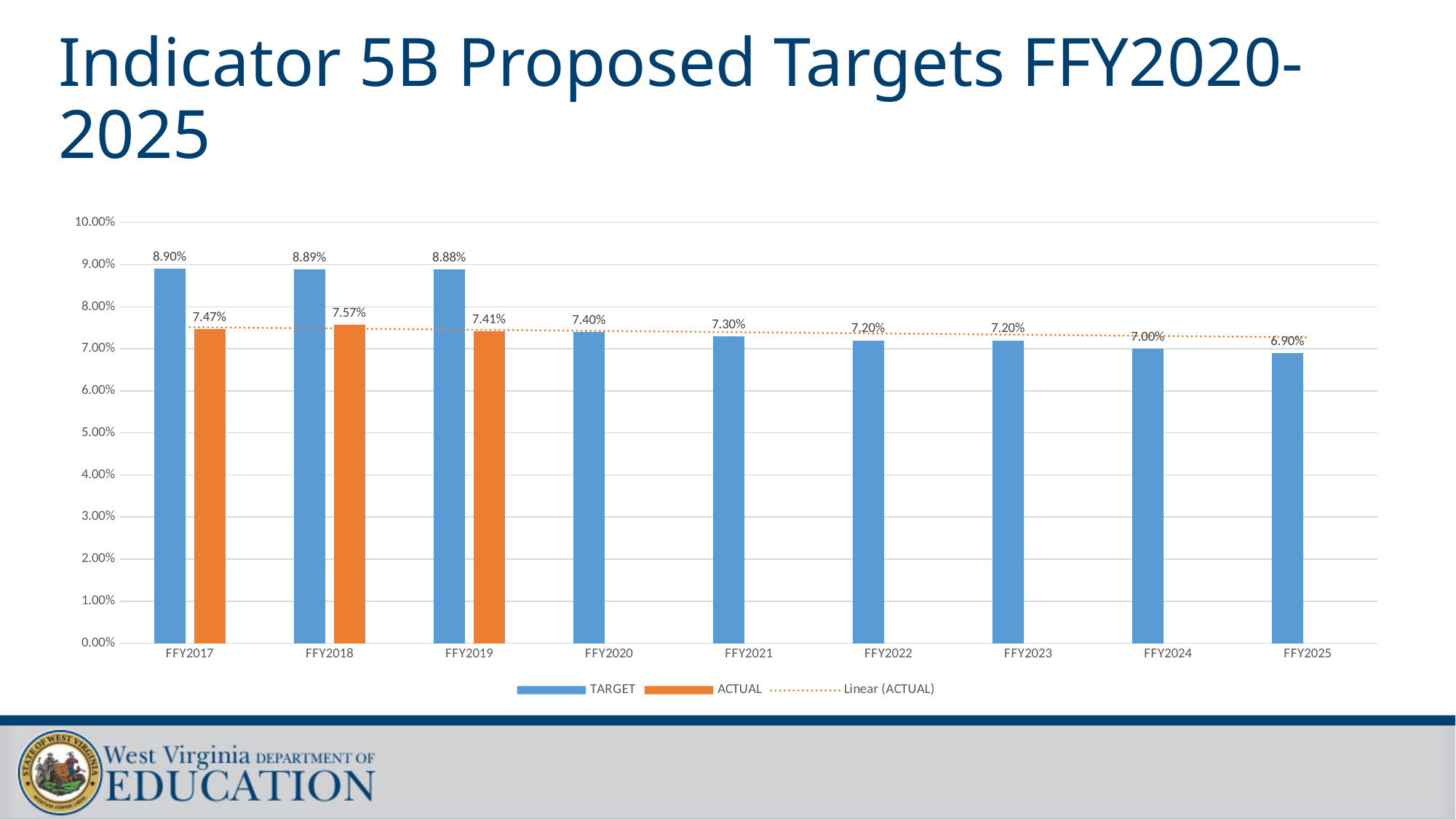
How many years are shown on the x axis? 9 Which year has the lowest TARGET value? FFY2025 What is the ACTUAL value for FFY2019? 7.41% Do the TARGET values rise or fall from FFY2020 to FFY2025? Fall What is the TARGET value for FFY2025? 6.90% What kind of chart is shown on the slide? Bar chart What is the difference between the TARGET and ACTUAL values for FFY2017? 1.43% Which year has the highest TARGET value? FFY2017 Which is larger for FFY2018, the TARGET or the ACTUAL value? TARGET How many entries does the legend list? 3 What is the TARGET value for FFY2017? 8.90% What is the ACTUAL value for FFY2018? 7.57%